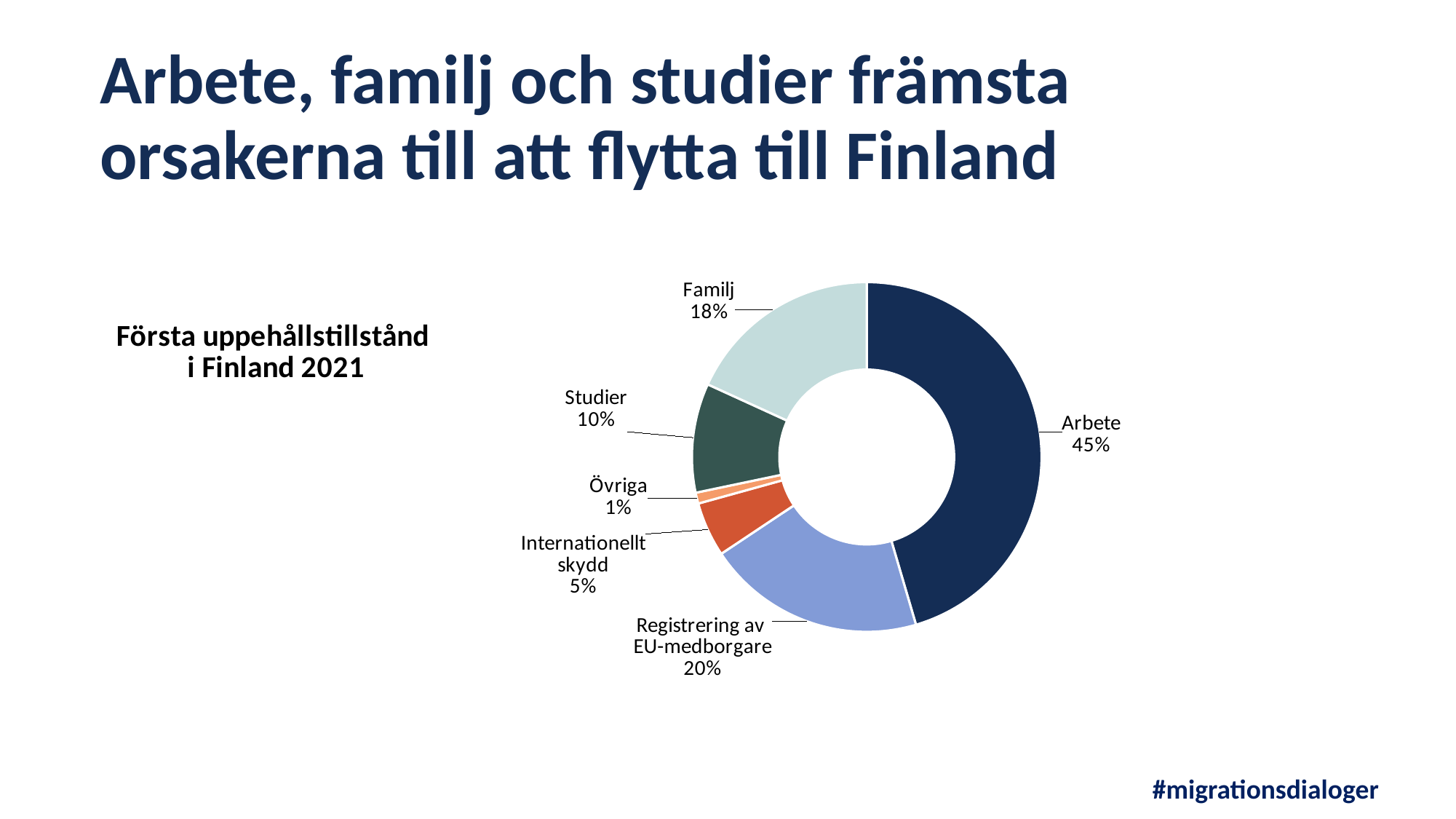
Which is larger, the share for Familj or the share for Studier? Familj What is the value shown for Registrering av EU-medborgare? 20% What kind of chart is shown on the slide? Pie chart (doughnut) How many categories are shown in the chart? 6 What share of first residence permits in Finland 2021 is for Arbete? 45% Which category has the largest share of the pie? Arbete What is the difference in percentage points between Arbete and Registrering av EU-medborgare? 25 What percentage is shown for Internationellt skydd? 5% Which category has the smallest share of the pie? Övriga What is the title of the chart? Första uppehållstillstånd i Finland 2021 What is the combined share of Studier and Familj? 28% What percentage does the Familj slice represent? 18%